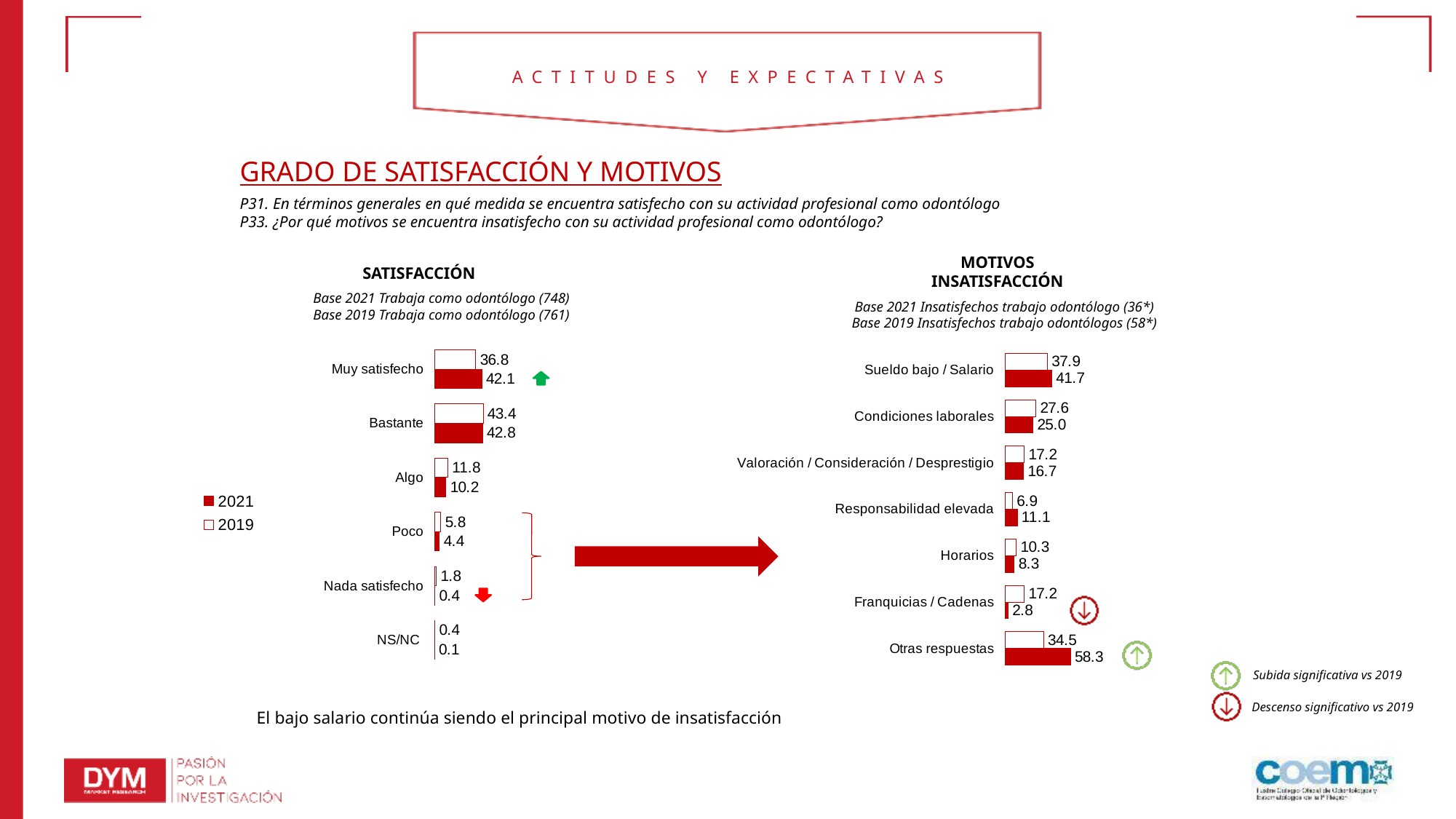
In the MOTIVOS INSATISFACCIÓN chart, which category has the highest 2021 value? Otras respuestas In the SATISFACCIÓN chart, what is the 2019 value for Bastante? 43.4 How many series does the legend list? 2 In the SATISFACCIÓN chart, how many categories are shown? 6 In the MOTIVOS INSATISFACCIÓN chart, is the 2021 value for Responsabilidad elevada larger or smaller than the 2021 value for Horarios? larger In the MOTIVOS INSATISFACCIÓN chart, what is the 2021 value for Sueldo bajo / Salario? 41.7 In the SATISFACCIÓN chart, what is the difference between the 2021 and 2019 values for Muy satisfecho? 5.3 In the MOTIVOS INSATISFACCIÓN chart, what is the 2019 value for Franquicias / Cadenas? 17.2 In the SATISFACCIÓN chart, what is the 2021 value for Muy satisfecho? 42.1 In the MOTIVOS INSATISFACCIÓN chart, what is the difference between the 2019 and 2021 values for Franquicias / Cadenas? 14.4 In the SATISFACCIÓN chart, which category has the lowest 2021 value? NS/NC What type of chart is the SATISFACCIÓN chart? bar chart